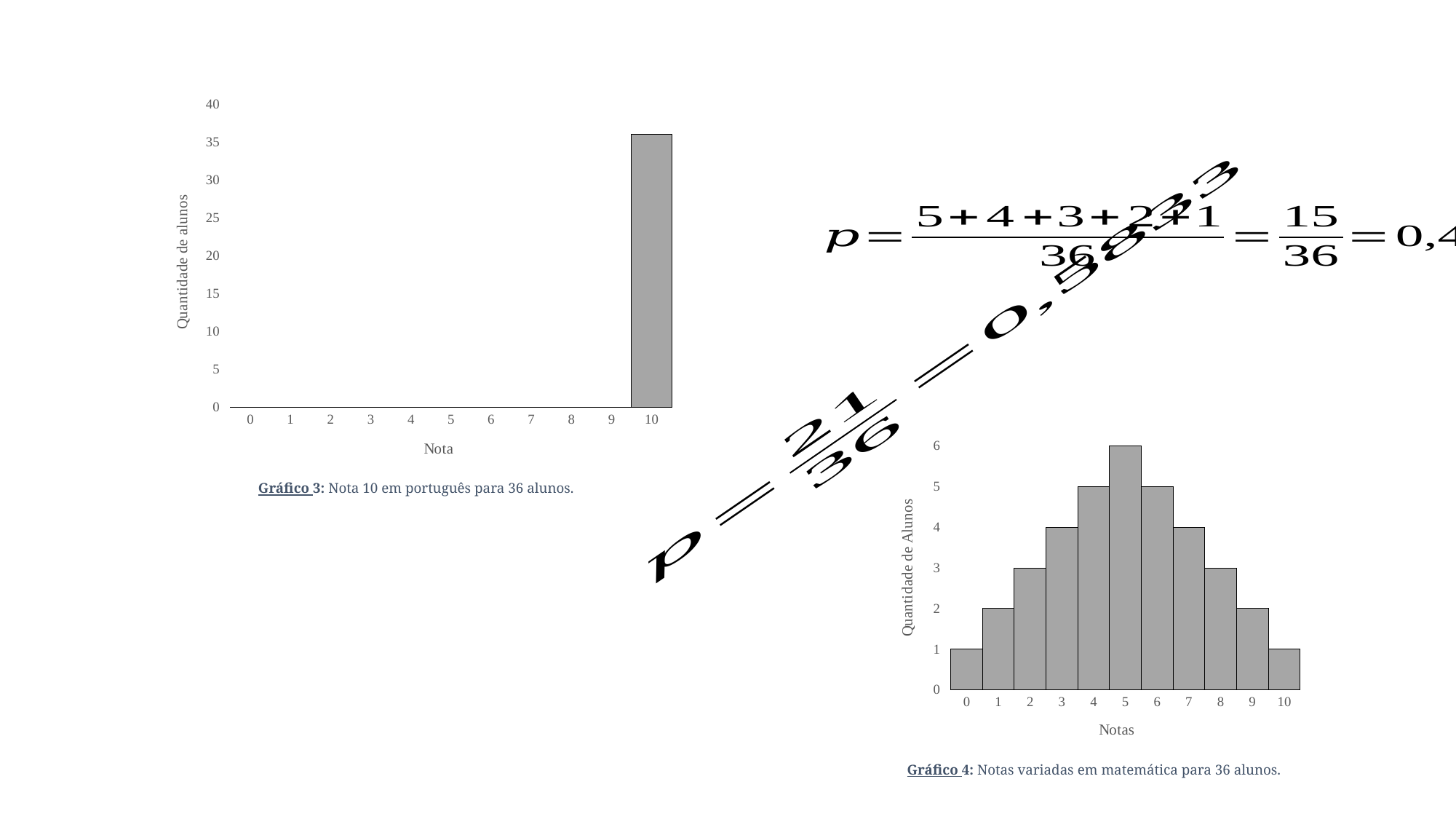
In Gráfico 4, do the values rise or fall from nota 0 to nota 5? rise In Gráfico 4, what is the quantidade de alunos for nota 0? 1 In Gráfico 3, which nota has the highest bar? 10 In Gráfico 4, what is the quantidade de alunos for nota 9? 2 In Gráfico 3, is the value for nota 10 greater or less than 30? greater In Gráfico 4, which nota has the highest number of alunos? 5 In Gráfico 4, what is the difference between the values for nota 5 and nota 2? 3 In Gráfico 4, what is the quantidade de alunos for nota 5? 6 In Gráfico 4, which has more alunos, nota 4 or nota 7? nota 4 How many nota categories are shown on the x axis of Gráfico 3? 11 What kind of chart is Gráfico 3? bar chart What is the y-axis label of Gráfico 3? Quantidade de alunos